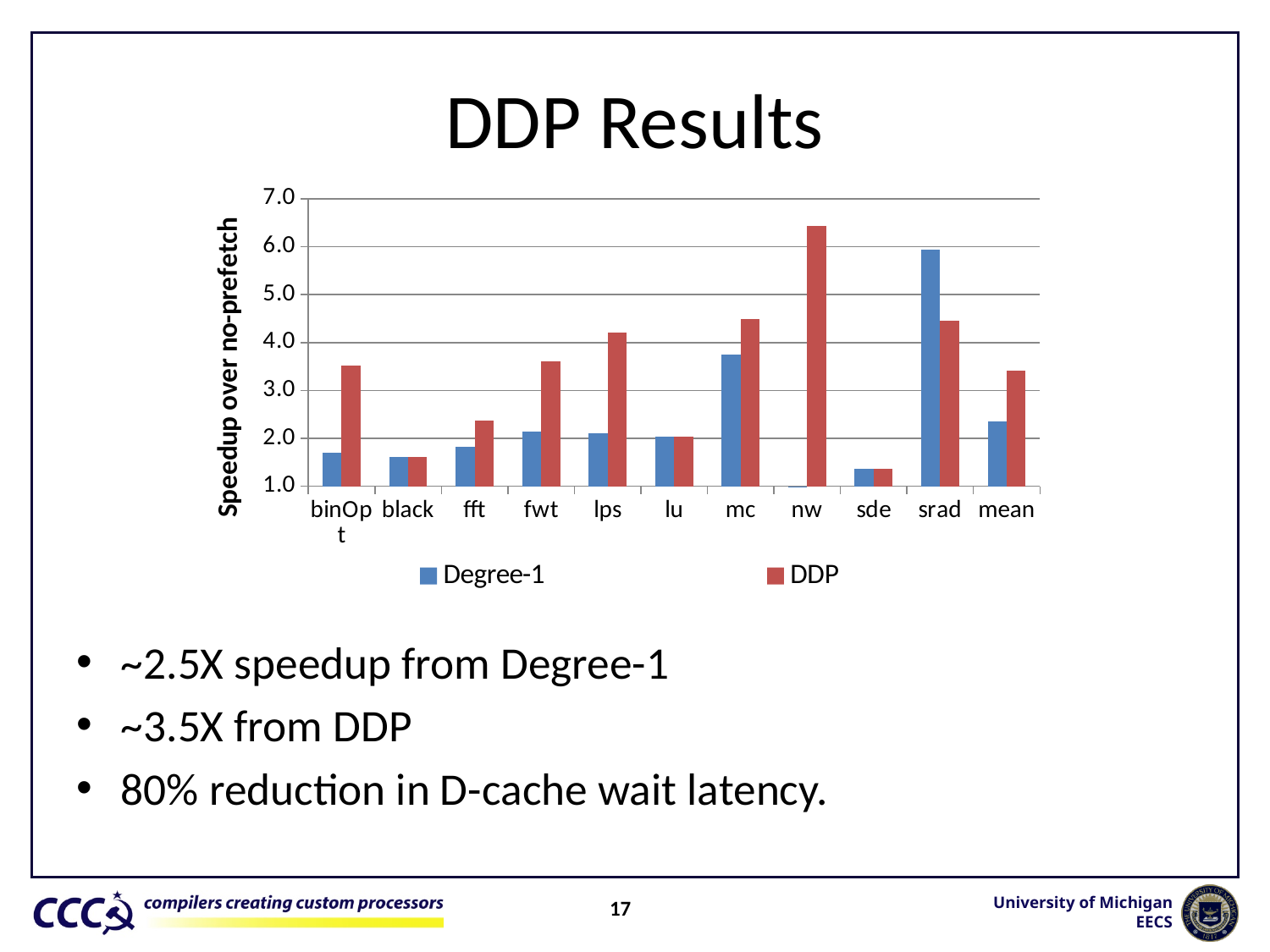
How many benchmark categories are shown on the x axis? 11 How many series does the legend list? 2 What is the label on the y axis? Speedup over no-prefetch Which category has the highest Degree-1 speedup? srad Is the DDP value for nw greater or less than 6.0? greater Is the Degree-1 value for srad greater or less than 5.0? greater Is the DDP value for binOpt greater or less than 3.0? greater Which category has the highest DDP speedup? nw Which category has the lowest Degree-1 speedup? nw For srad, which series has the larger speedup, Degree-1 or DDP? Degree-1 What kind of chart is shown on the slide? bar chart